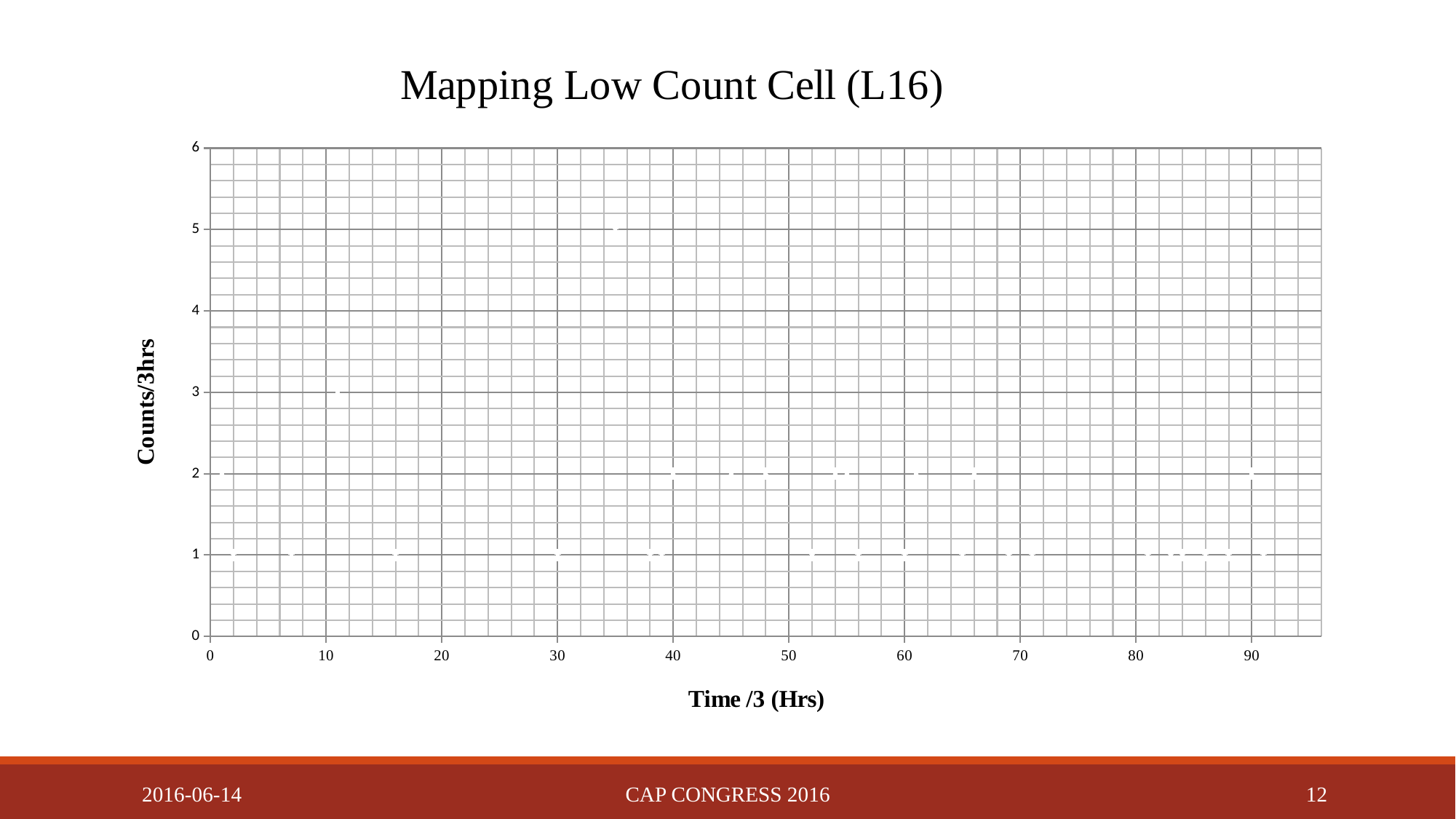
What kind of chart is shown on the slide? Scatter chart Is the point plotted near time 11 greater or less than 2 counts/3hrs? greater What is the title of the chart? Mapping Low Count Cell (L16) What is the difference between the highest plotted value and the lowest plotted value? 4 Is the highest plotted point greater or less than 4 counts/3hrs? greater Which is larger: the point plotted near time 35 or the point plotted near time 11? The point near time 35 What is the highest count value reached by any plotted point? 5 How many plotted points reach a value of 3 counts/3hrs? 1 What is the lowest count value reached by any plotted point? 1 How many plotted points reach a value of 5 counts/3hrs? 1 What is the maximum value shown on the vertical axis? 6 What is the label of the vertical axis? Counts/3hrs